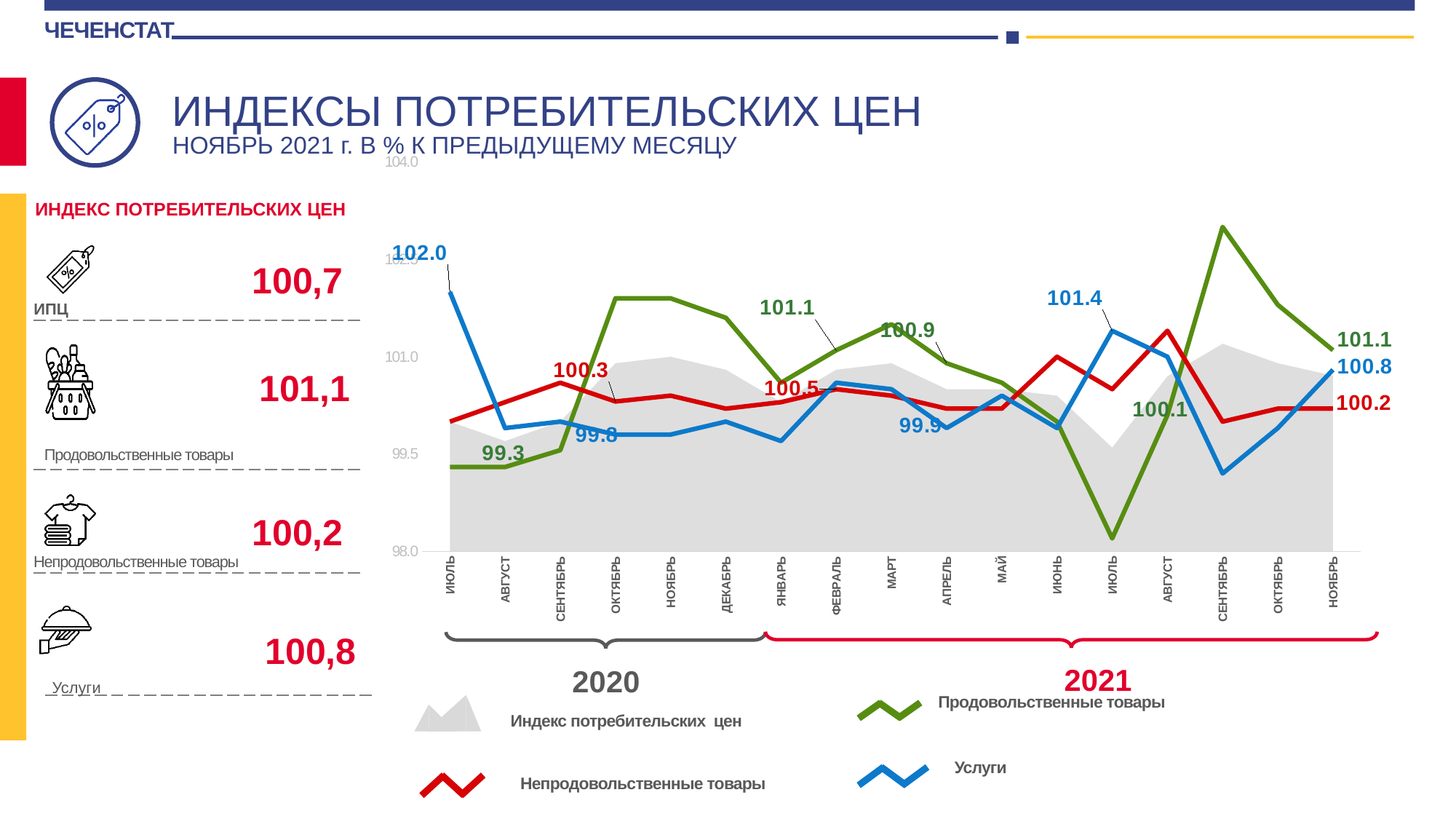
What is the value of Непродовольственные товары for Ноябрь 2021 on the chart? 100.2 Is the value of Продовольственные товары for Сентябрь 2021 greater or less than 101.0? greater What kind of chart is shown on the slide? combination area and line chart How many series does the chart legend list? 4 How many months are plotted along the x axis of the chart? 17 What is the difference between Продовольственные товары and Непродовольственные товары in Ноябрь 2021? 0.9 What is the value of Услуги for Июль 2020 on the chart? 102.0 In which month does the Продовольственные товары line reach its lowest point? Июль 2021 What is the value of Услуги for Ноябрь 2021 on the chart? 100.8 In Ноябрь 2021, which is larger: Продовольственные товары or Непродовольственные товары? Продовольственные товары Which series has the highest value in Ноябрь 2021 on the chart? Продовольственные товары What is the value of Продовольственные товары for Ноябрь 2021 on the chart? 101.1